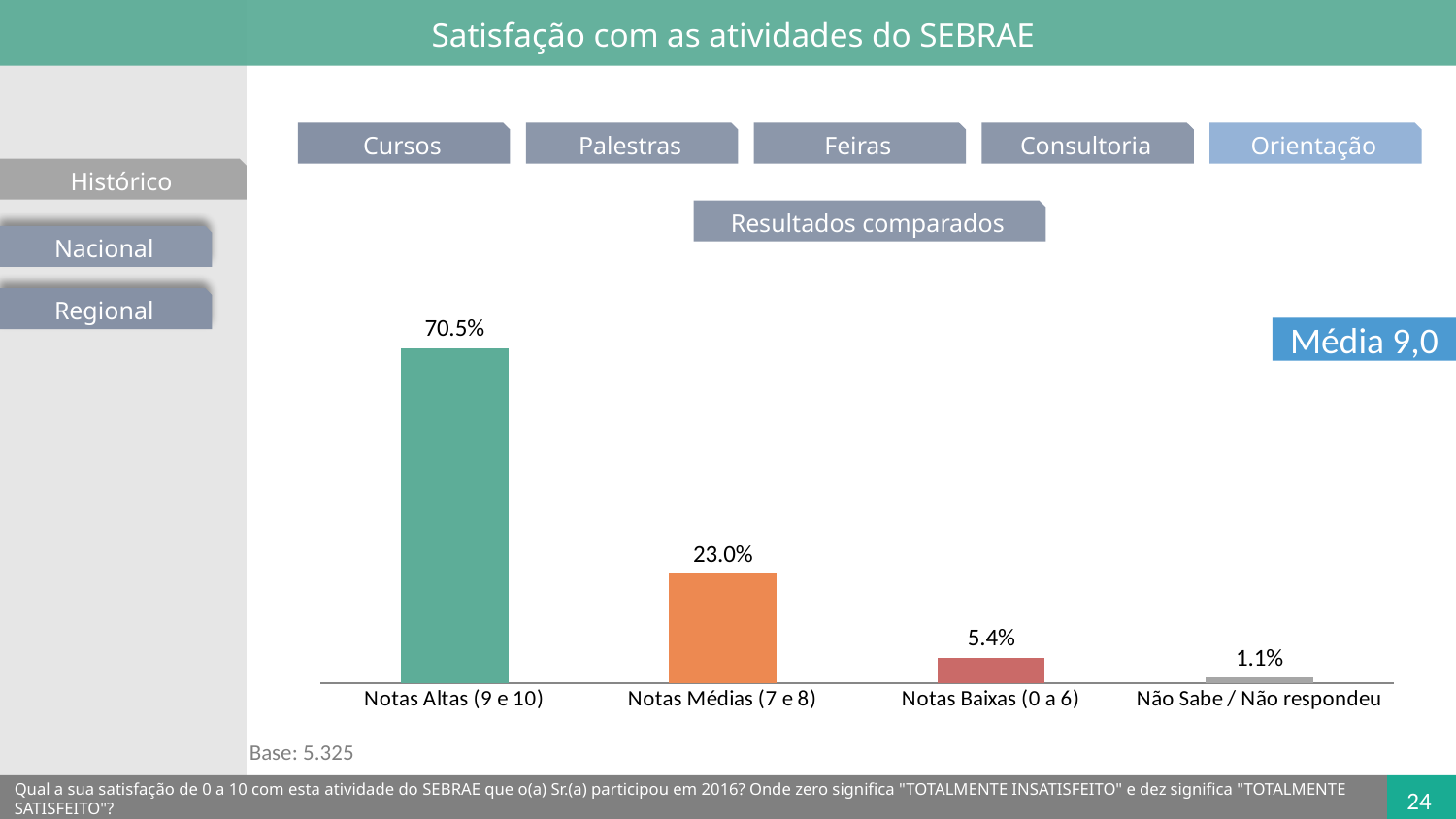
What kind of chart is shown on the slide? Bar chart Which is larger, the value for Notas Médias (7 e 8) or the value for Notas Baixas (0 a 6)? Notas Médias (7 e 8) How many categories are shown in the chart? 4 What is the value for Não Sabe / Não respondeu? 1.1% What is the difference between the values for Notas Baixas (0 a 6) and Não Sabe / Não respondeu? 4.3% What is the value for Notas Baixas (0 a 6)? 5.4% Which category has the highest value? Notas Altas (9 e 10) What is the value for Notas Médias (7 e 8)? 23.0% What is the average (Média) shown on the slide? 9,0 Which category has the lowest value? Não Sabe / Não respondeu What is the difference between the values for Notas Altas (9 e 10) and Notas Médias (7 e 8)? 47.5% What is the value for Notas Altas (9 e 10)? 70.5%